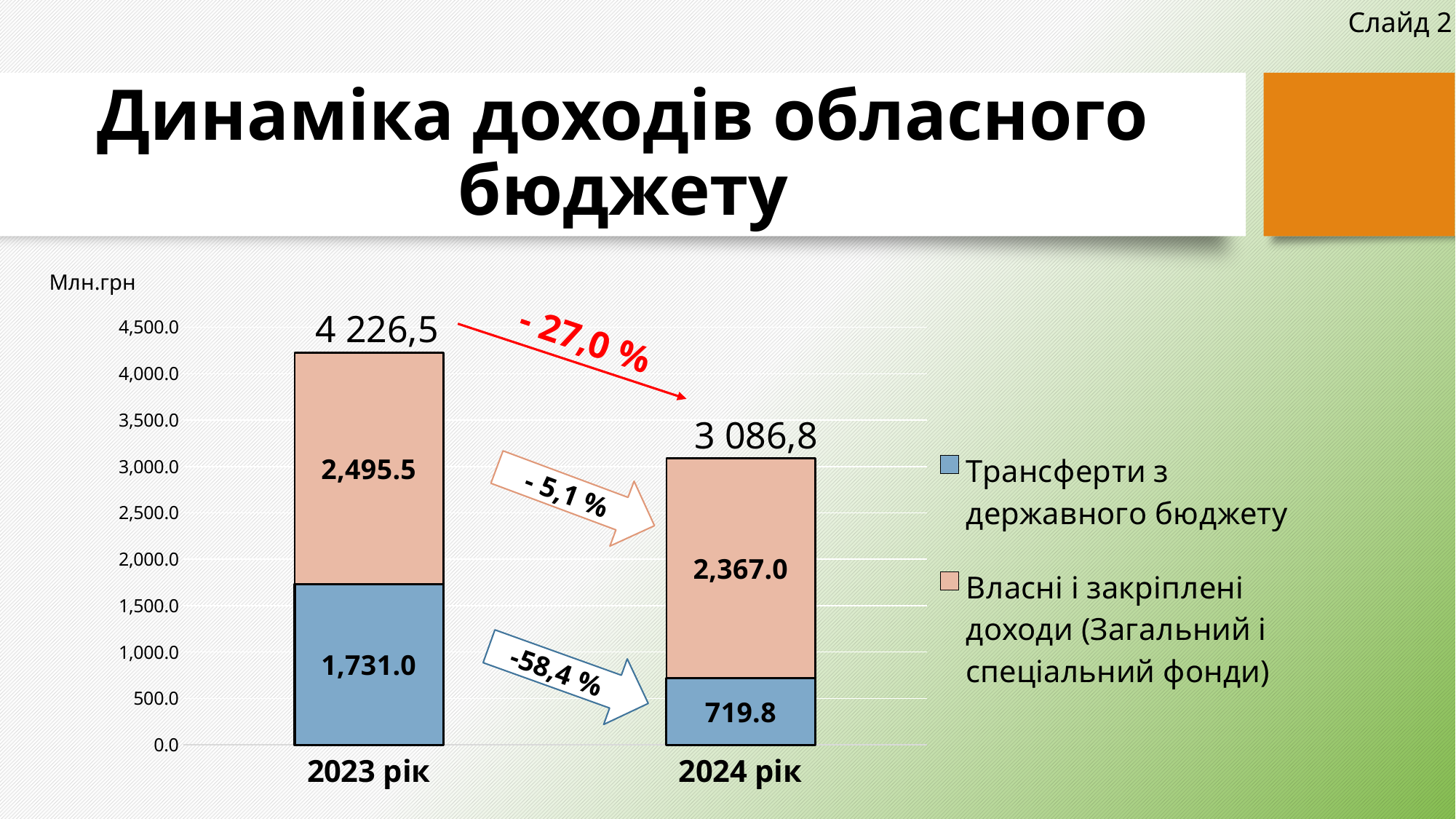
What is the total of the stacked bar for 2023 рік? 4 226,5 What is the value of Трансферти з державного бюджету for 2023 рік? 1,731.0 What percentage change is shown by the red arrow between the two bar totals? - 27,0 % Which category has the lowest total bar? 2024 рік How many categories are shown on the x axis? 2 What is the total of the stacked bar for 2024 рік? 3 086,8 Which year has the larger value for Власні і закріплені доходи (Загальний і спеціальний фонди), 2023 рік or 2024 рік? 2023 рік What is the value of Трансферти з державного бюджету for 2024 рік? 719.8 What kind of chart is shown on the slide? Stacked bar chart What is the value of Власні і закріплені доходи (Загальний і спеціальний фонди) for 2024 рік? 2,367.0 What is the difference between the Трансферти з державного бюджету values for 2023 рік and 2024 рік? 1,011.2 How many series does the legend list? 2